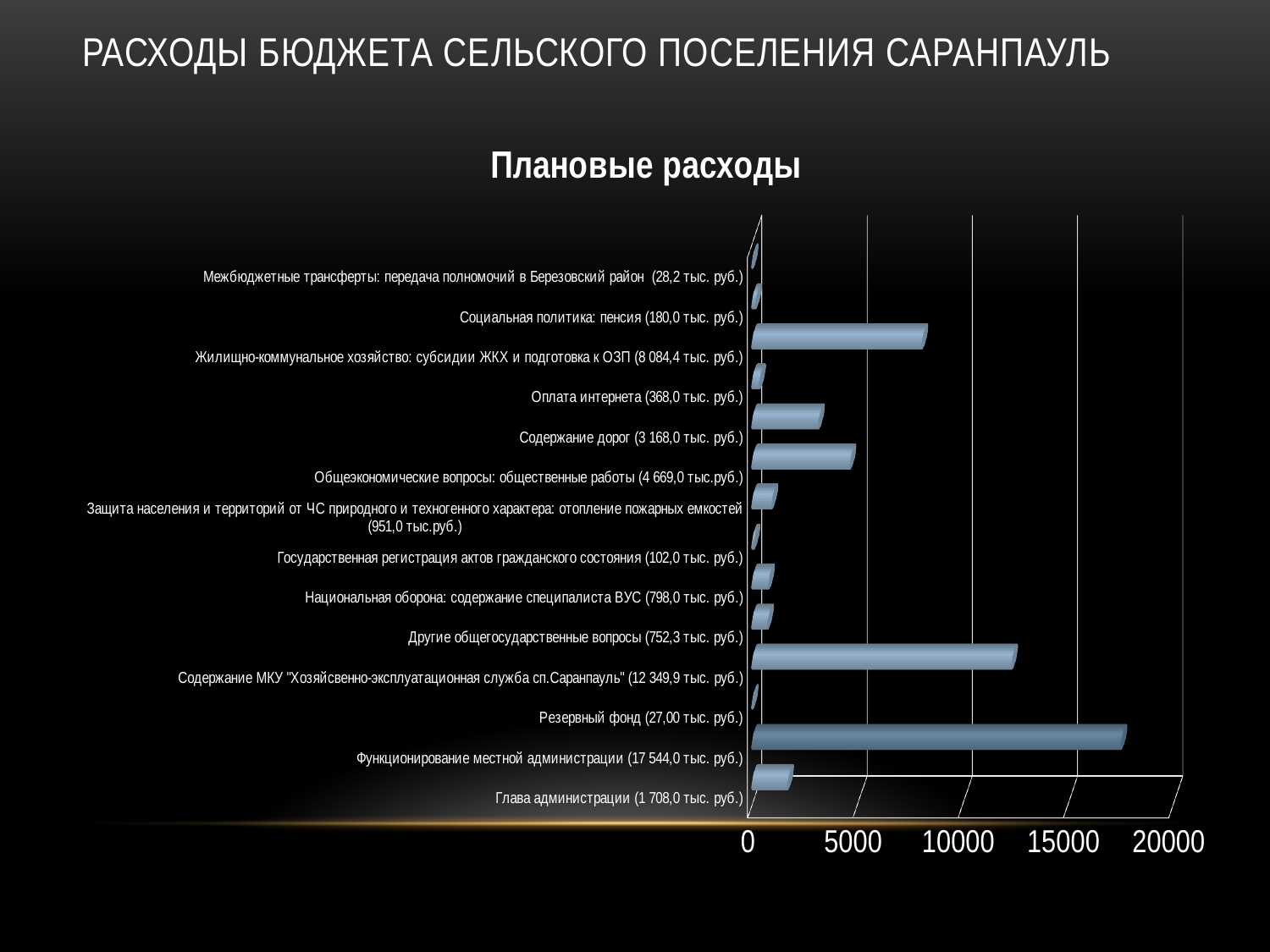
What is the planned expenditure for Содержание дорог? 3 168,0 тыс. руб. Which is larger: the planned expenditure for Жилищно-коммунальное хозяйство or for Общеэкономические вопросы? Жилищно-коммунальное хозяйство What is the maximum value shown on the horizontal axis? 20000 What is the title of the chart? Плановые расходы Is the value for Содержание МКУ "Хозяйсвенно-эксплуатационная служба сп.Саранпауль" greater or less than 10000? greater Which category has the highest planned expenditure? Функционирование местной администрации What kind of chart is shown on the slide? Bar chart How many categories are plotted in the chart? 14 What is the planned expenditure for Содержание МКУ "Хозяйсвенно-эксплуатационная служба сп.Саранпауль"? 12 349,9 тыс. руб. What is the planned expenditure for Функционирование местной администрации? 17 544,0 тыс. руб. What is the difference between the planned expenditure for Функционирование местной администрации and for Содержание МКУ "Хозяйсвенно-эксплуатационная служба сп.Саранпауль"? 5 194,1 тыс. руб. Is the value for Содержание дорог greater or less than 5000? less